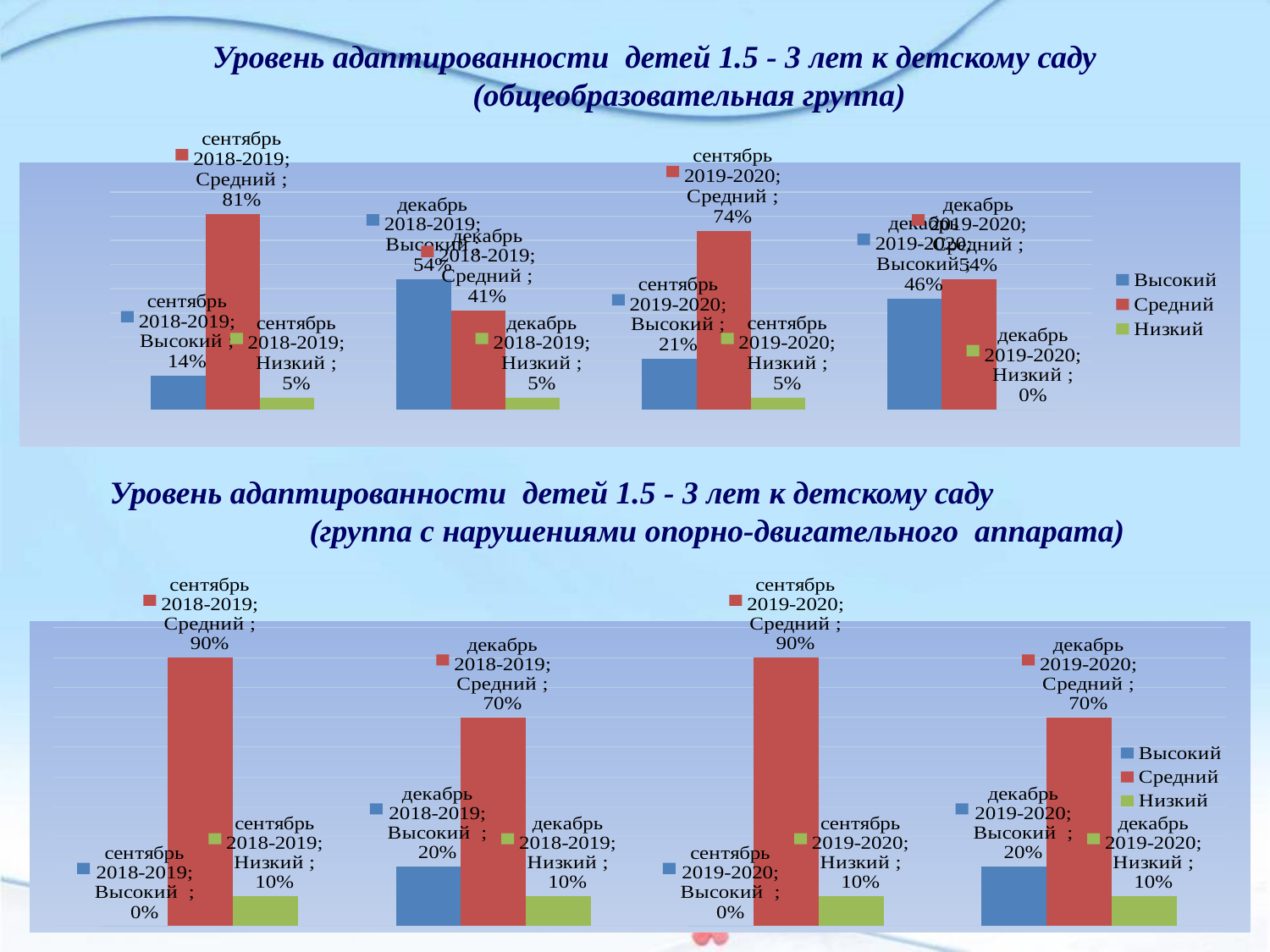
In the bottom chart (группа с нарушениями опорно-двигательного аппарата), what is the value for Средний in декабрь 2018-2019? 70% In the bottom chart (группа с нарушениями опорно-двигательного аппарата), what is the value for Высокий in сентябрь 2019-2020? 0% In the top chart (общеобразовательная группа), what is the value for Средний in сентябрь 2018-2019? 81% In the bottom chart (группа с нарушениями опорно-двигательного аппарата), what is the difference between the Средний values in сентябрь 2018-2019 and декабрь 2018-2019? 20% How many series does the legend of the top chart (общеобразовательная группа) list? 3 In the top chart (общеобразовательная группа), which is larger in декабрь 2019-2020: Высокий or Средний? Средний In the top chart (общеобразовательная группа), what is the value for Высокий in декабрь 2018-2019? 54% In the top chart (общеобразовательная группа), which period has the highest Средний value? сентябрь 2018-2019 What type of chart is the bottom chart (группа с нарушениями опорно-двигательного аппарата)? bar chart In the top chart (общеобразовательная группа), what is the difference between the Средний and Высокий values in сентябрь 2019-2020? 53% In the bottom chart (группа с нарушениями опорно-двигательного аппарата), which colour represents the Низкий series? green In the top chart (общеобразовательная группа), what is the value for Низкий in декабрь 2019-2020? 0%